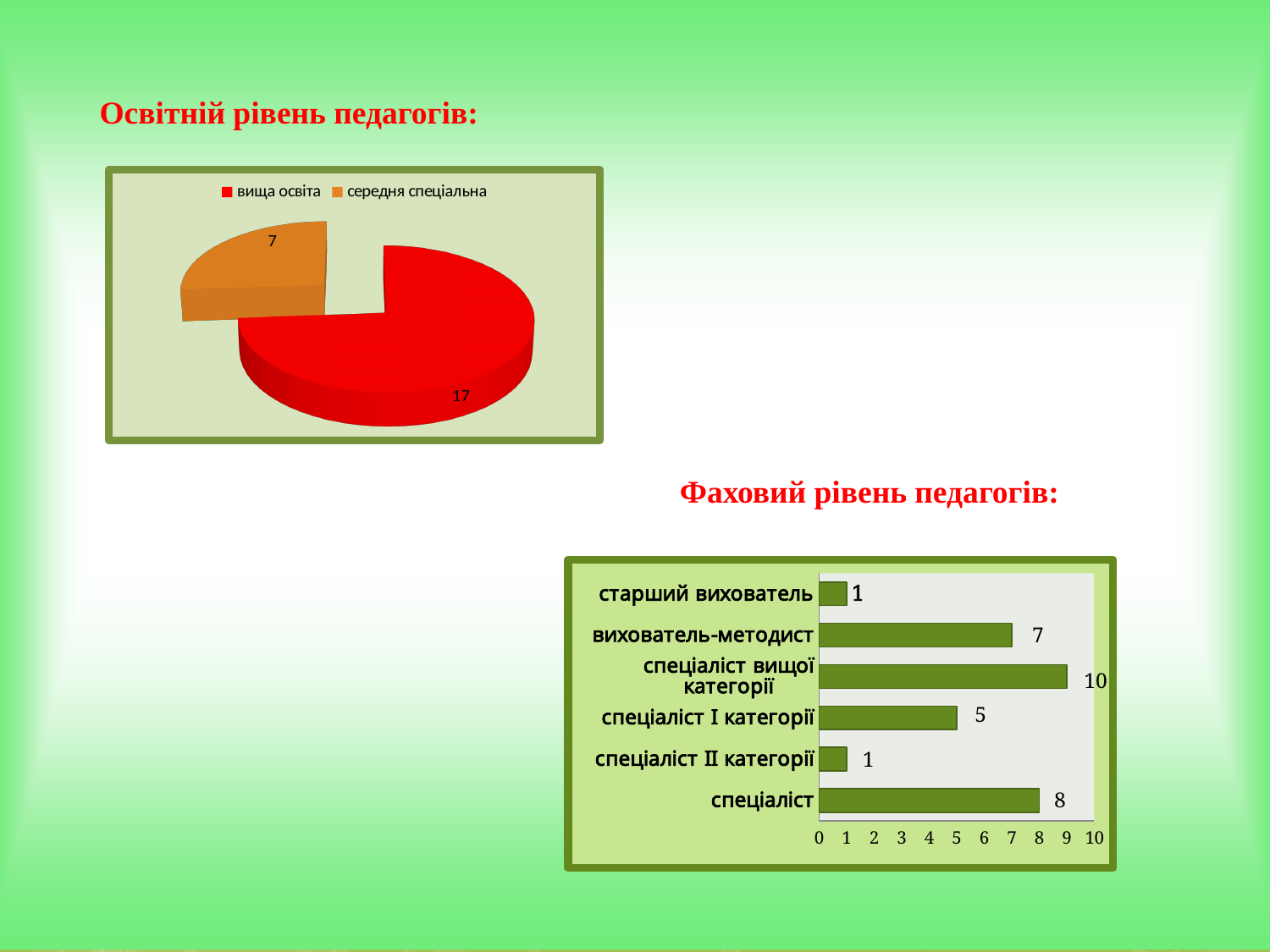
In the bar chart under "Фаховий рівень педагогів:", which category has the highest value? спеціаліст вищої категорії In the pie chart under "Освітній рівень педагогів:", what is the difference between the "вища освіта" and "середня спеціальна" values? 10 What kind of chart is shown under "Фаховий рівень педагогів:"? bar chart In the pie chart under "Освітній рівень педагогів:", how many slices does the pie have? 2 In the pie chart under "Освітній рівень педагогів:", what is the value for "вища освіта"? 17 In the pie chart under "Освітній рівень педагогів:", what colour is the "середня спеціальна" slice? orange In the pie chart under "Освітній рівень педагогів:", which slice is larger, "вища освіта" or "середня спеціальна"? вища освіта In the bar chart under "Фаховий рівень педагогів:", what is the value for "вихователь-методист"? 7 In the pie chart under "Освітній рівень педагогів:", what is the value for "середня спеціальна"? 7 In the bar chart under "Фаховий рівень педагогів:", what is the difference between the values for "спеціаліст" and "спеціаліст I категорії"? 3 In the bar chart under "Фаховий рівень педагогів:", what is the value for "спеціаліст вищої категорії"? 10 In the bar chart under "Фаховий рівень педагогів:", how many categories are shown? 6